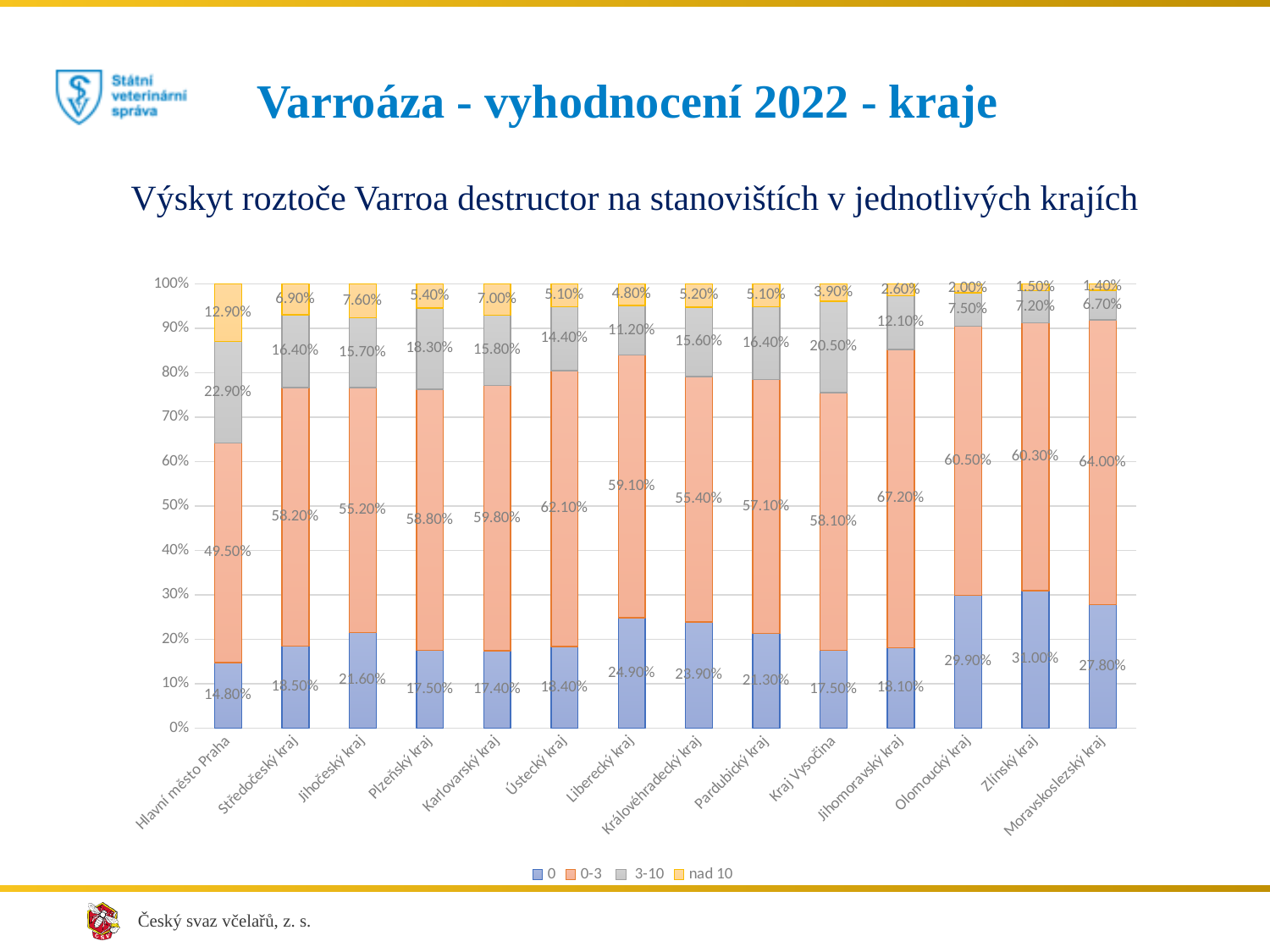
How many regions are shown on the x axis? 14 Which region has the lowest value in the "nad 10" series? Moravskoslezský kraj How many series does the legend list? 4 What is the value of the "3-10" series for Kraj Vysočina? 20.50% What is the value of the "nad 10" series for Jihočeský kraj? 7.60% What kind of chart is shown on the slide? Stacked bar chart Which region has the highest value in the "nad 10" series? Hlavní město Praha What is the value of the "0-3" series for Jihomoravský kraj? 67.20% What is the value of the "0" series for Hlavní město Praha? 14.80% Which is larger: the "3-10" value for Plzeňský kraj or for Liberecký kraj? Plzeňský kraj What is the difference between the "0-3" values for Ústecký kraj and Středočeský kraj? 3.90% Which region has the highest value in the "0" series? Zlínský kraj